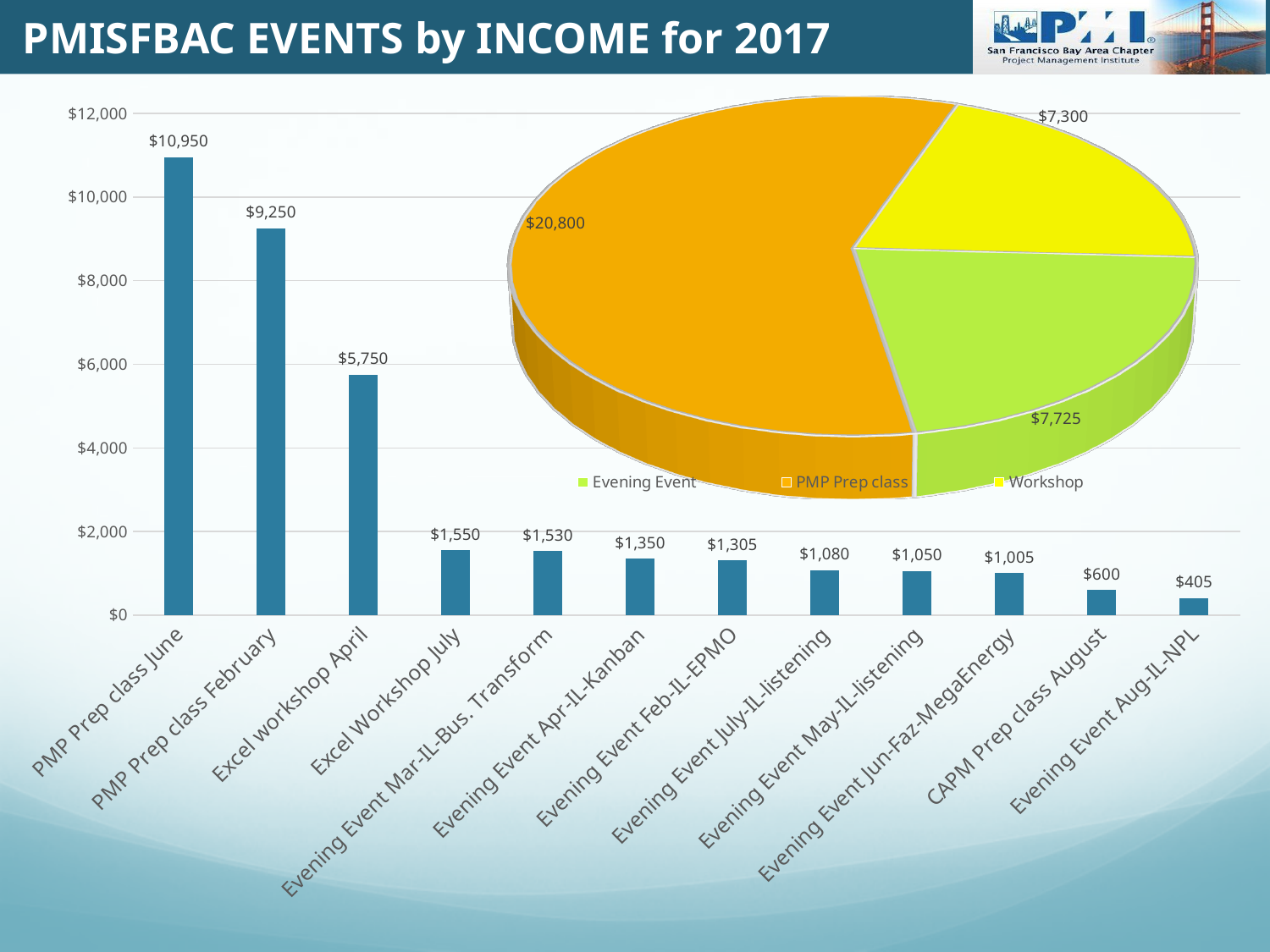
On the bar chart, what is the income for Evening Event Apr-IL-Kanban? $1,350 On the pie chart, what is the difference between the Evening Event and Workshop values? $425 On the pie chart, what is the value for PMP Prep class? $20,800 How many events are shown on the bar chart? 12 What type of chart is the chart on the left of the slide? Bar chart On the bar chart, which event has the highest income? PMP Prep class June On the pie chart, which category has the smallest value? Workshop On the bar chart, what is the income for PMP Prep class June? $10,950 On the bar chart, what is the difference in income between PMP Prep class June and PMP Prep class February? $1,700 On the bar chart, which event has the lowest income? Evening Event Aug-IL-NPL How many categories does the pie chart's legend list? 3 On the bar chart, which has the larger income, Excel workshop April or Excel Workshop July? Excel workshop April